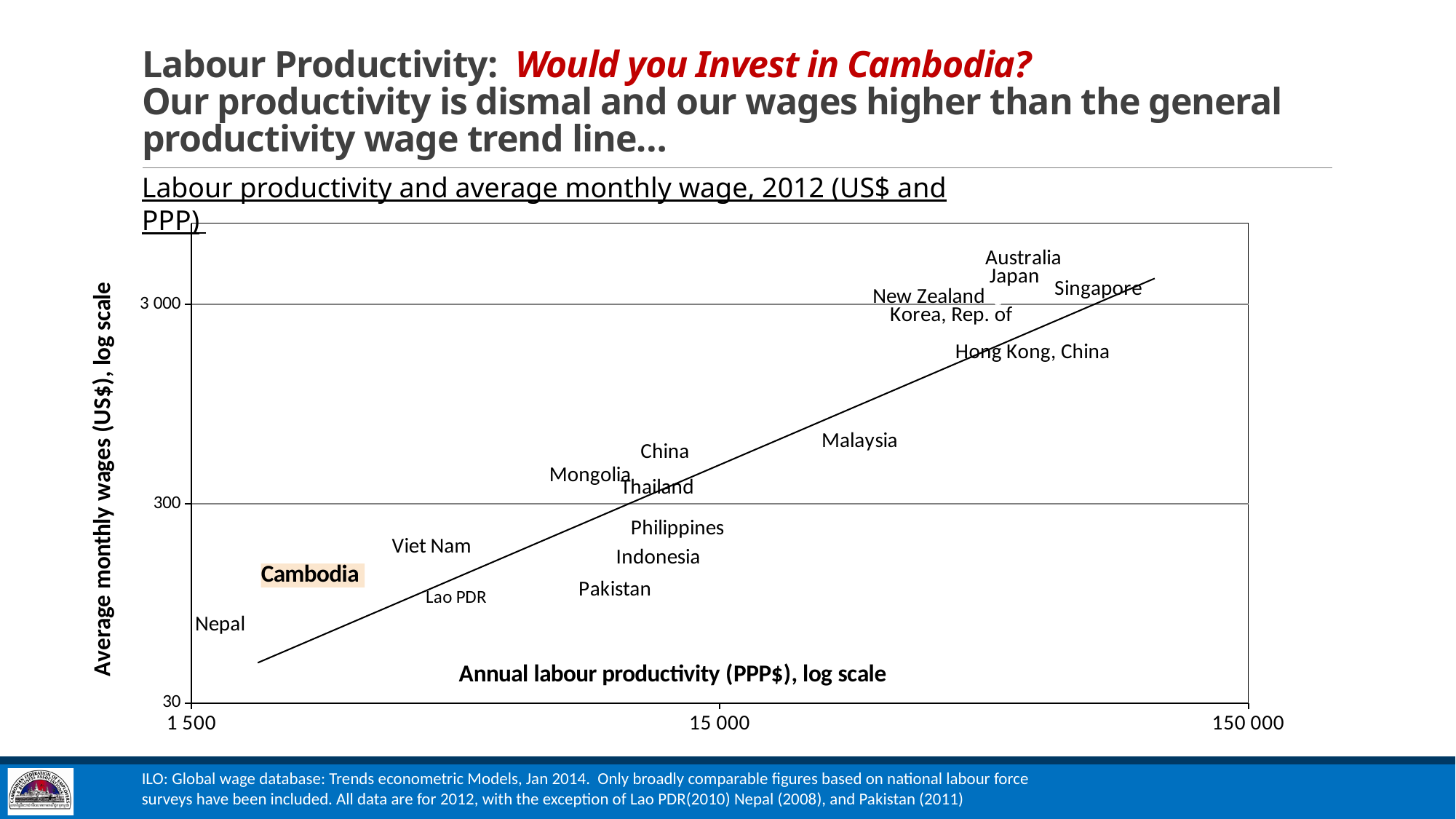
Which has the higher average monthly wage, China or Pakistan? China Is the average monthly wage for Cambodia greater or less than 300? less What kind of chart is shown on the slide? scatter chart Is the annual labour productivity for Malaysia greater or less than 15 000? greater Is the average monthly wage for Malaysia greater or less than 300? greater Which labelled country has the highest average monthly wage on the chart? Australia What is the title of the chart? Labour productivity and average monthly wage, 2012 (US$ and PPP) What is the label of the x axis of the chart? Annual labour productivity (PPP$), log scale Which labelled country has the lowest average monthly wage on the chart? Nepal How many countries or economies are labelled on the chart? 17